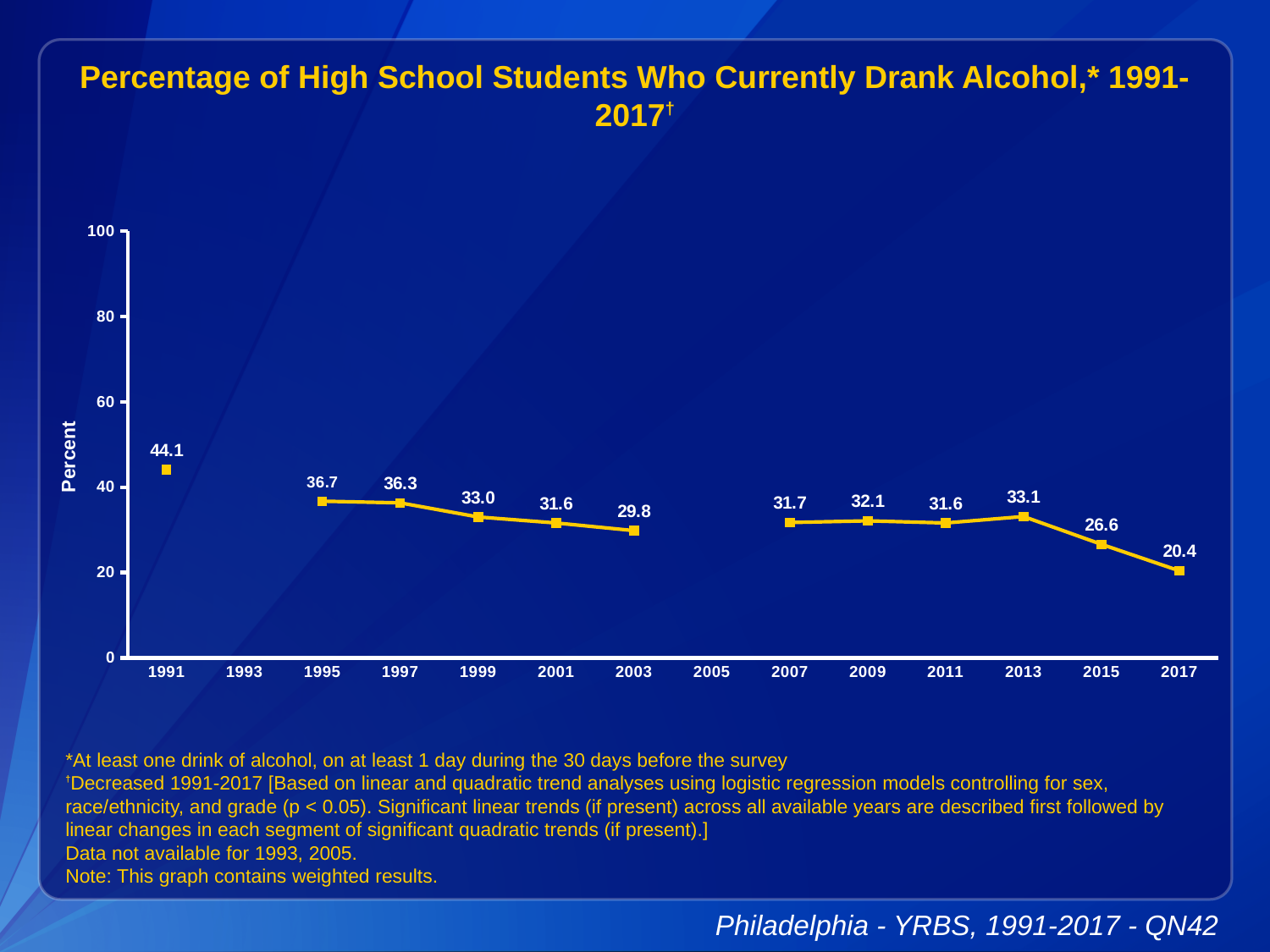
What is the difference between the 1991 value and the 2017 value? 23.7 Does the percentage rise or fall from 2013 to 2017? fall Which year has the lowest percentage? 2017 Which is larger, the value for 1995 or the value for 2009? 1995 What is the value plotted for 2013? 33.1 Is the value for 2015 greater or less than 20? greater What percentage of high school students currently drank alcohol in 1991? 44.1 What is the difference between the 2013 value and the 2015 value? 6.5 How many years have data points plotted on the chart? 12 What is the value plotted for 2017? 20.4 Which year has the highest percentage? 1991 What kind of chart is shown on the slide? line chart